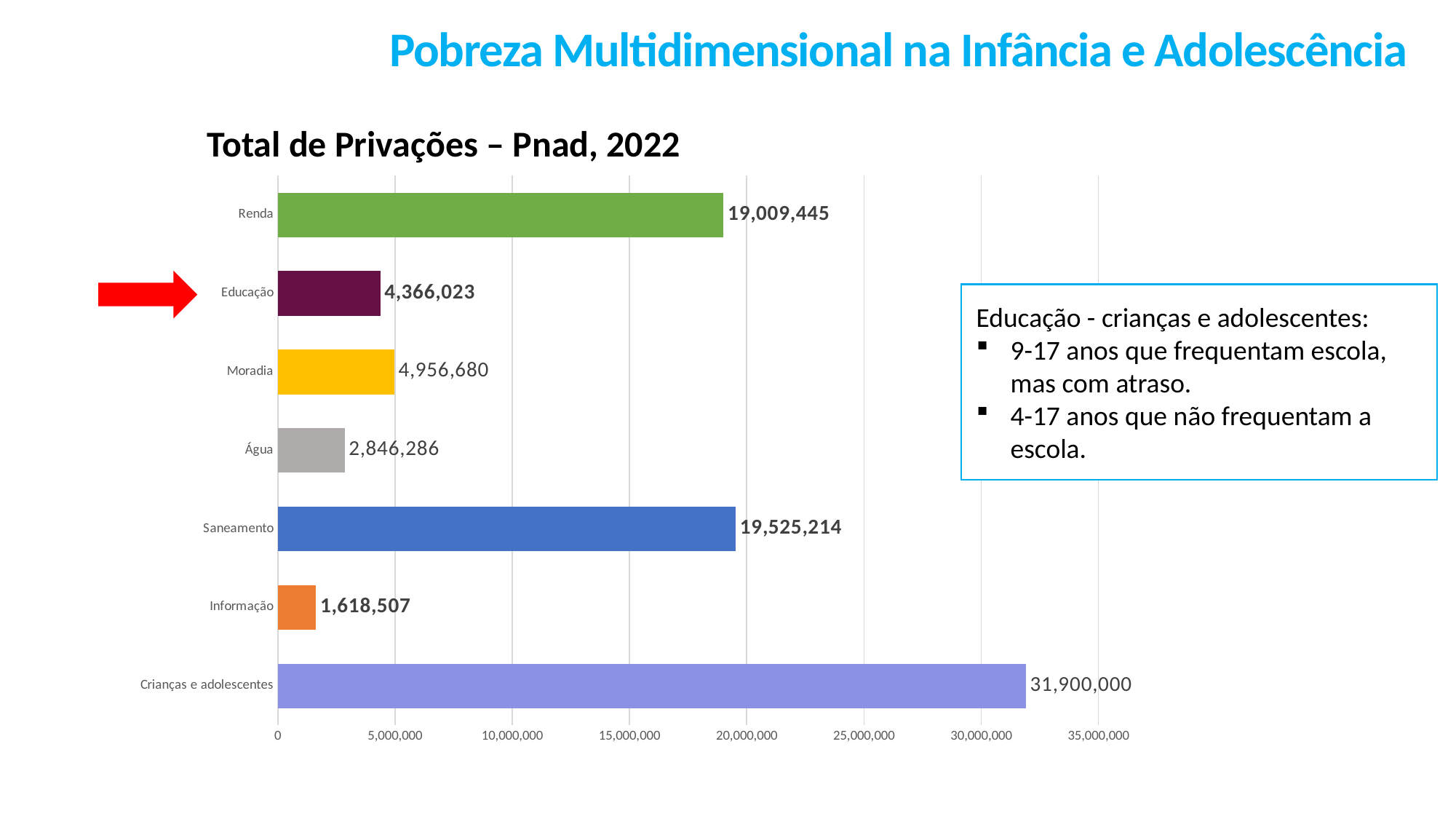
What is the title of the chart? Total de Privações – Pnad, 2022 Which category has the highest value? Crianças e adolescentes What is the difference between Saneamento and Renda? 515,769 What is the difference between Moradia and Educação? 590,657 Which is larger, Moradia or Água? Moradia How many categories are shown in the chart? 7 Is the value for Renda greater or less than 20,000,000? less What is the value for Crianças e adolescentes? 31,900,000 What is the value for Educação? 4,366,023 Which category has the lowest value? Informação What kind of chart is shown? bar chart What is the value for Saneamento? 19,525,214